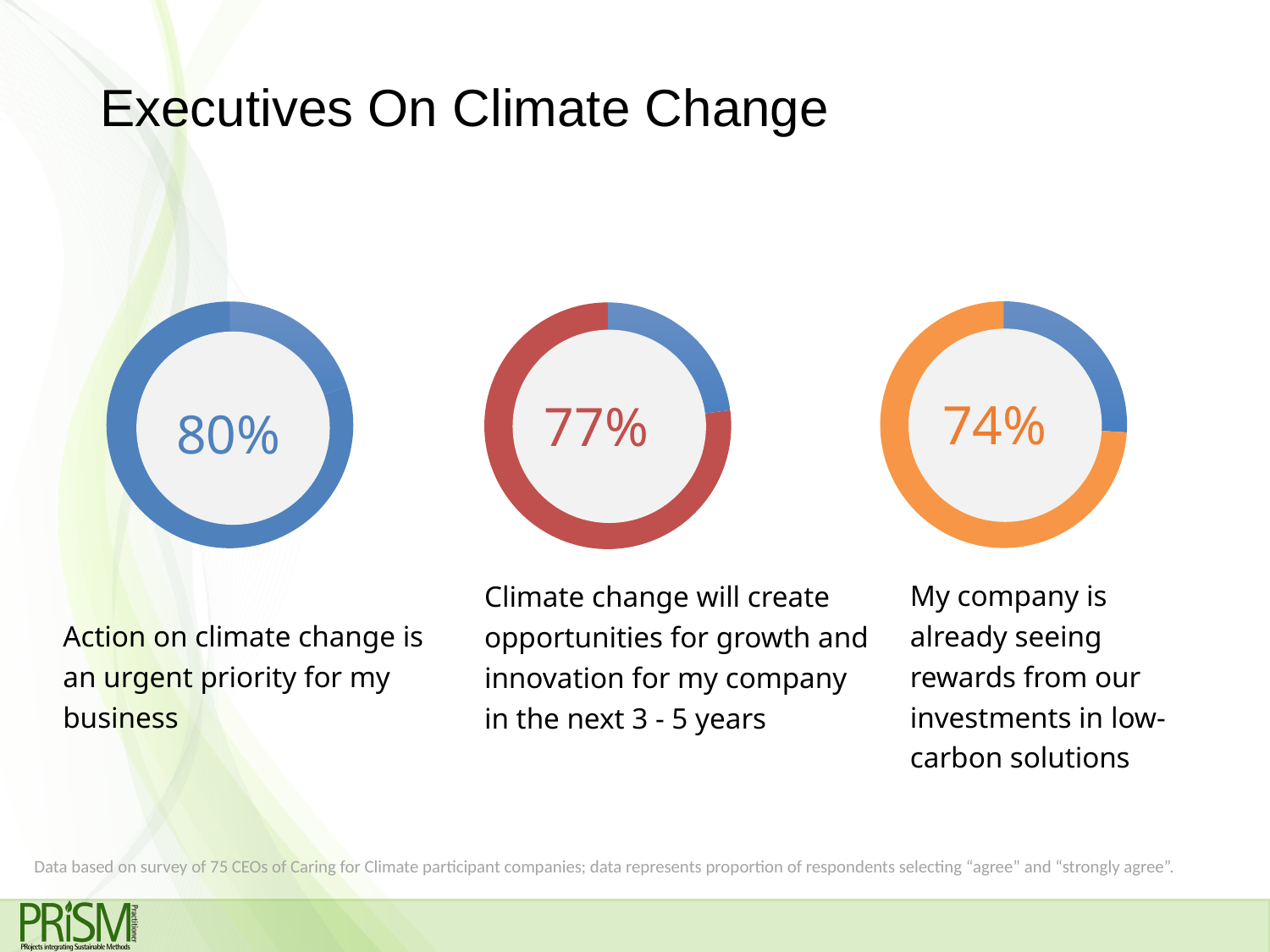
How many donut charts are shown on the slide? 3 Which of the three statements on the slide has the lowest percentage of agreement? My company is already seeing rewards from our investments in low-carbon solutions What kind of chart is used to display each percentage on the slide? Donut (pie) chart What percentage is shown in the left donut chart, for 'Action on climate change is an urgent priority for my business'? 80% Which of the three statements on the slide has the highest percentage of agreement? Action on climate change is an urgent priority for my business What is the difference in percentage points between the left donut chart (80%) and the middle donut chart (77%)? 3 What is the title of the slide containing the three donut charts? Executives On Climate Change Which is larger: the percentage in the middle donut chart or the percentage in the right donut chart? The middle donut chart (77%) What is the difference in percentage points between the left donut chart (80%) and the right donut chart (74%)? 6 What percentage is shown in the middle donut chart, for 'Climate change will create opportunities for growth and innovation for my company in the next 3 - 5 years'? 77% What percentage is shown in the right donut chart, for 'My company is already seeing rewards from our investments in low-carbon solutions'? 74% What colour is the filled portion of the right donut chart showing 74%? Orange